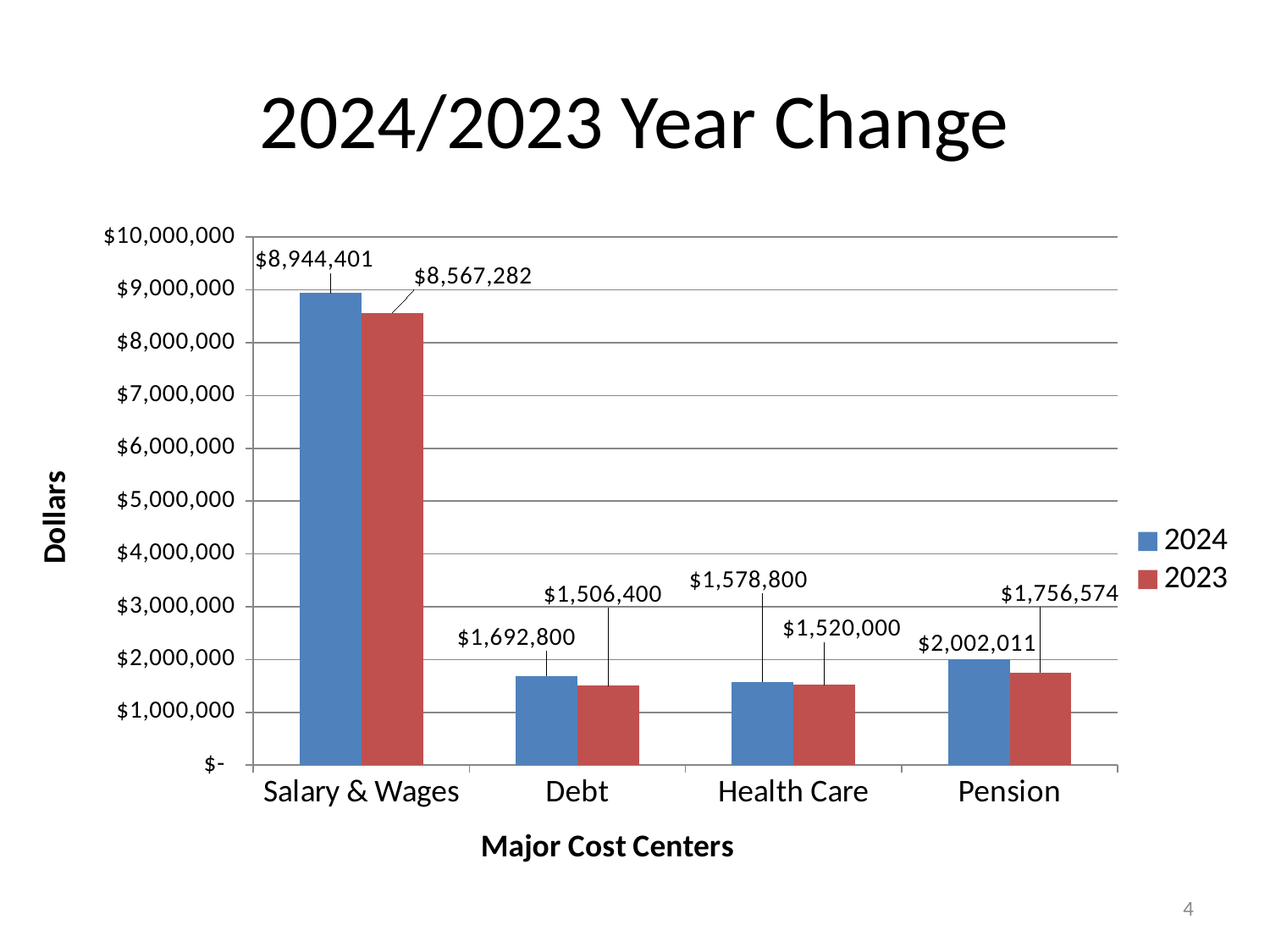
What is the 2023 value for Pension? $1,756,574 What is the difference between the 2024 and 2023 values for Salary & Wages? $377,119 Which cost center has the lowest 2023 value? Debt What is the 2024 value for Salary & Wages? $8,944,401 What is the 2024 value for Debt? $1,692,800 What is the difference between the 2024 and 2023 values for Pension? $245,437 Which is larger for Debt, the 2024 value or the 2023 value? 2024 How many series does the legend list? 2 Which cost center has the highest 2024 value? Salary & Wages What is the 2023 value for Health Care? $1,520,000 How many cost centers are shown on the x axis? 4 What type of chart is shown on the slide? Bar chart